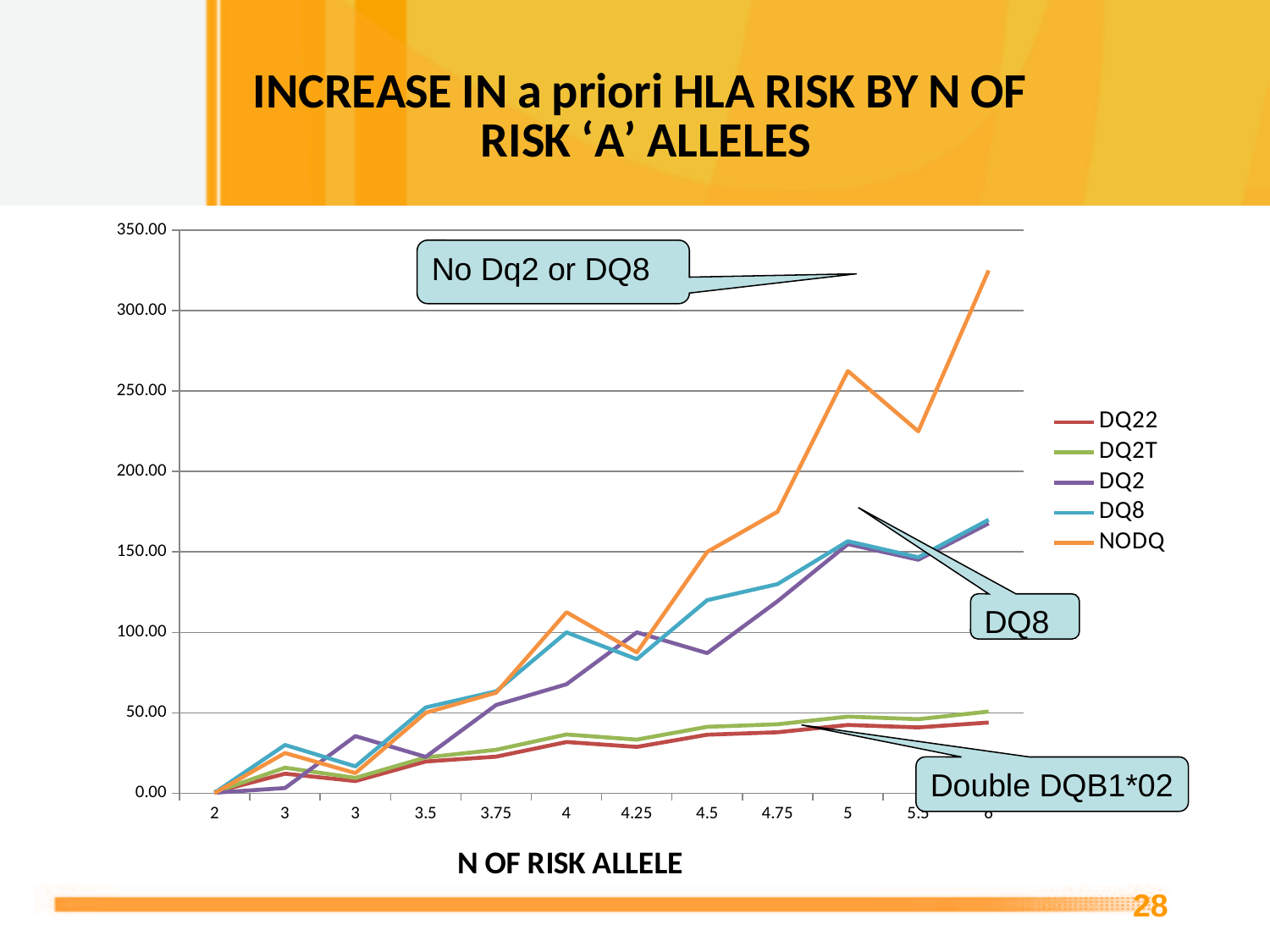
Is the value for NODQ at 6 risk alleles greater or less than 300? greater What kind of chart is shown on the slide? line chart Is the value for DQ2 at 4.5 risk alleles greater or less than 100? less What is the title of the x axis? N OF RISK ALLELE Does the NODQ series generally rise or fall as the number of risk alleles increases? rise At 5 risk alleles, which is larger: NODQ or DQ8? NODQ Which series reaches the highest value at the right end of the chart? NODQ What does the callout pointing to the top line say? No Dq2 or DQ8 Is the value for DQ8 at 4.5 risk alleles greater or less than 100? greater How many series does the legend list? 5